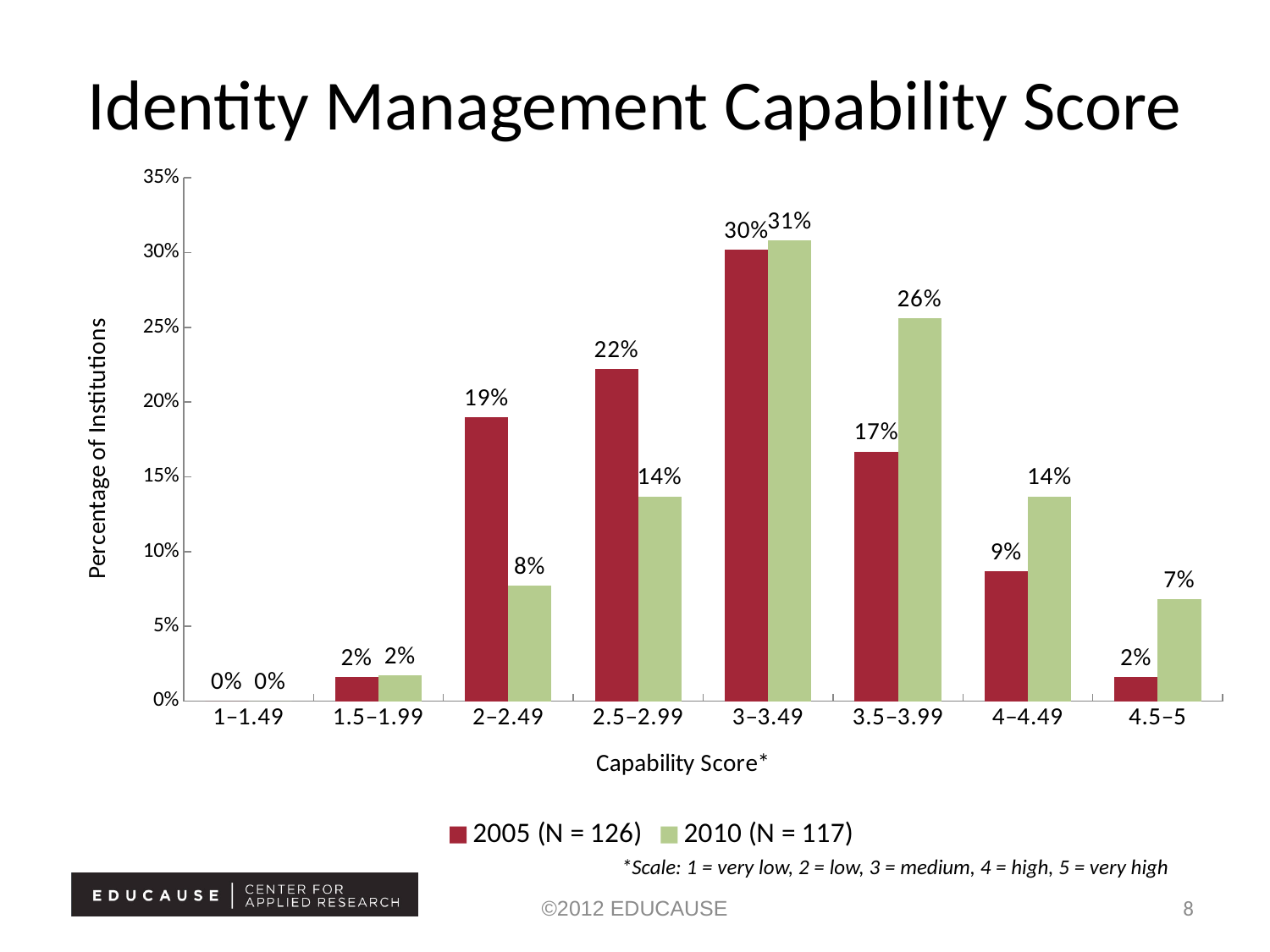
What is the difference between the 2005 and 2010 values for the 2–2.49 capability score range? 11% Which capability score range has the highest percentage of institutions in the 2010 series? 3–3.49 What percentage of institutions had a capability score of 3.5–3.99 in 2010? 26% For the 2.5–2.99 capability score range, which year has the larger percentage, 2005 or 2010? 2005 Which capability score range has the lowest percentage of institutions in the 2005 series? 1–1.49 What type of chart is shown on the slide? Bar chart How many series does the legend list? 2 What percentage of institutions had a capability score of 2–2.49 in 2005? 19% How many capability score ranges are shown on the x axis? 8 What is the difference between the 2010 and 2005 values for the 3.5–3.99 capability score range? 9% For the 4–4.49 capability score range, which year has the larger percentage, 2005 or 2010? 2010 What is the value for the 4.5–5 capability score range in the 2010 series? 7%